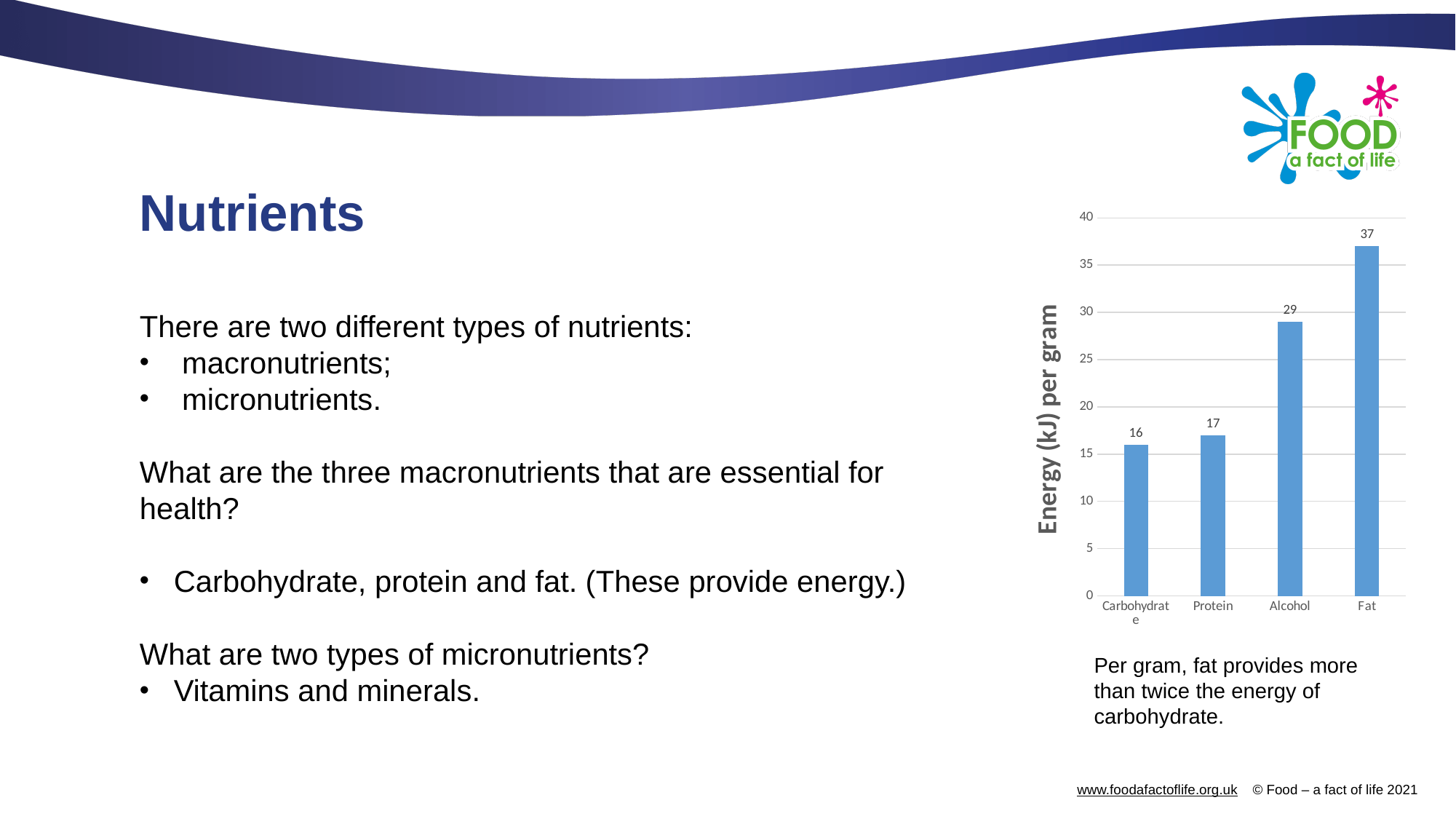
Which category has the highest energy per gram? Fat What is the difference in energy per gram between Alcohol and Protein? 12 Is the value for Alcohol greater or less than 25? greater How many categories are shown on the chart? 4 What is the energy (kJ) per gram for Carbohydrate? 16 What is the energy (kJ) per gram for Fat? 37 What is the energy (kJ) per gram for Protein? 17 What kind of chart is shown on the slide? Bar chart What is the energy (kJ) per gram for Alcohol? 29 Which provides more energy per gram, Alcohol or Protein? Alcohol What is the difference in energy per gram between Fat and Carbohydrate? 21 Which category has the lowest energy per gram? Carbohydrate